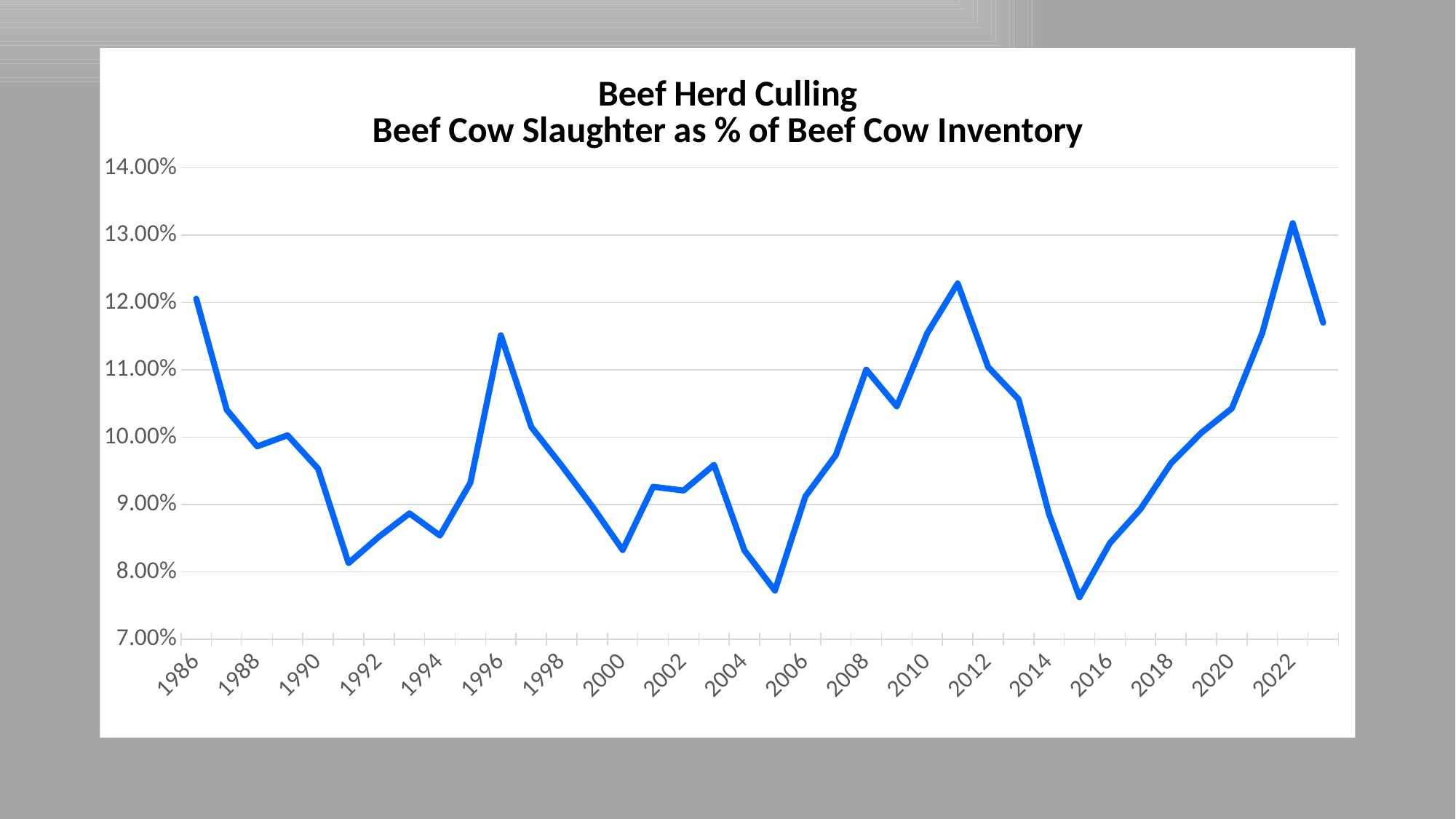
Does the value rise or fall from 2015 to 2022? rise Is the value for 1996 greater or less than 11.00%? greater Which is larger, the value for 1986 or the value for 1996? 1986 Is the value for 1991 greater or less than 9.00%? less What is the title of the chart? Beef Herd Culling Beef Cow Slaughter as % of Beef Cow Inventory Is the value for 2015 greater or less than 8.00%? less What kind of chart is shown on the slide? line chart Which year has the highest beef cow slaughter as % of beef cow inventory? 2022 Which is larger, the value for 2022 or the value for 2011? 2022